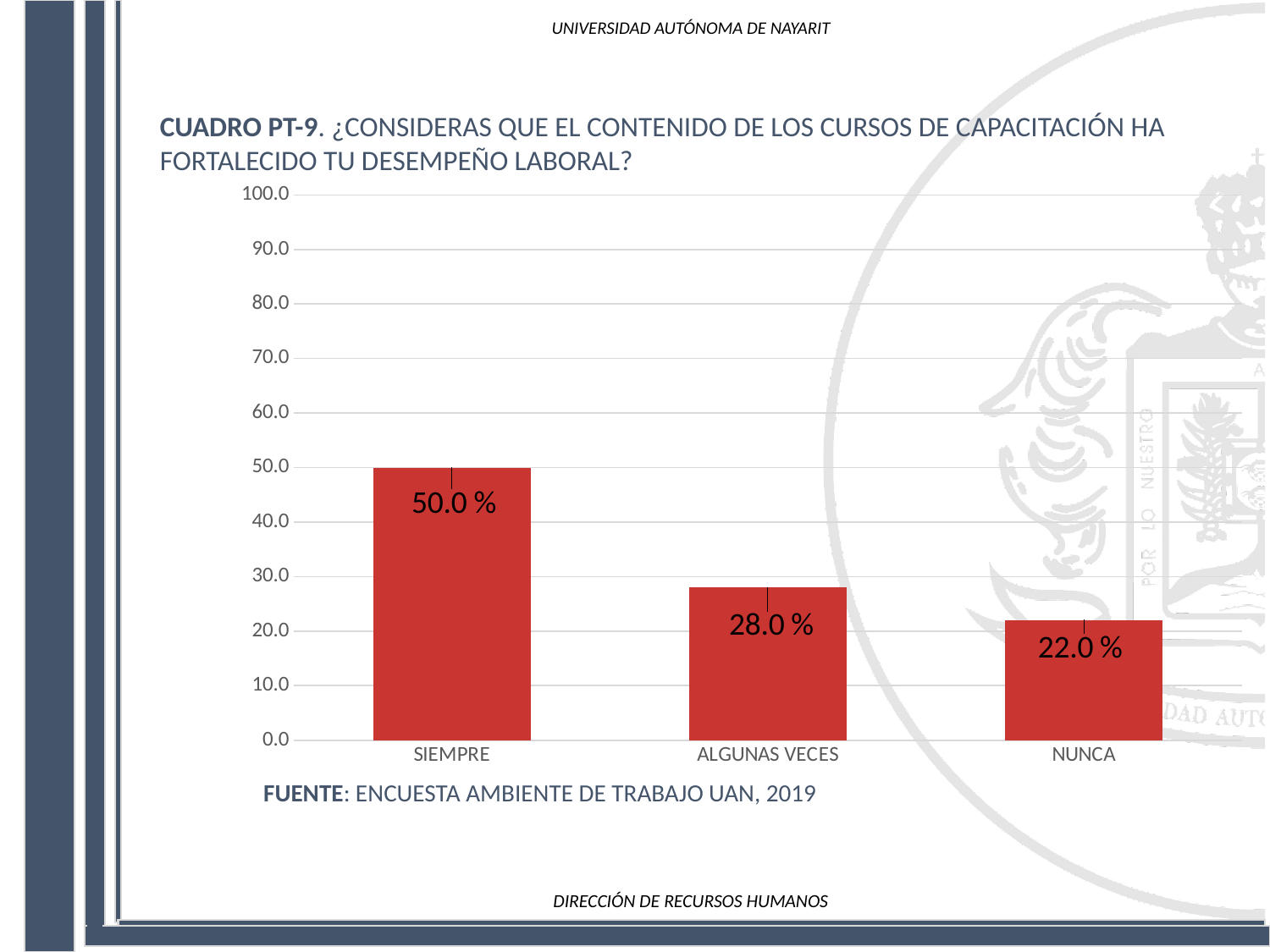
What is the difference between the values for SIEMPRE and ALGUNAS VECES? 22.0 % Which is larger, the value for ALGUNAS VECES or the value for NUNCA? ALGUNAS VECES What is the value for NUNCA? 22.0 % What is the value for SIEMPRE? 50.0 % Which category has the highest value? SIEMPRE What is the difference between the values for ALGUNAS VECES and NUNCA? 6.0 % Do the values rise or fall from left to right along the x axis? fall How many categories are shown on the x axis? 3 Which category has the lowest value? NUNCA What is the value for ALGUNAS VECES? 28.0 % Is the value for SIEMPRE greater or less than 40.0? greater What kind of chart is shown on the slide? bar chart